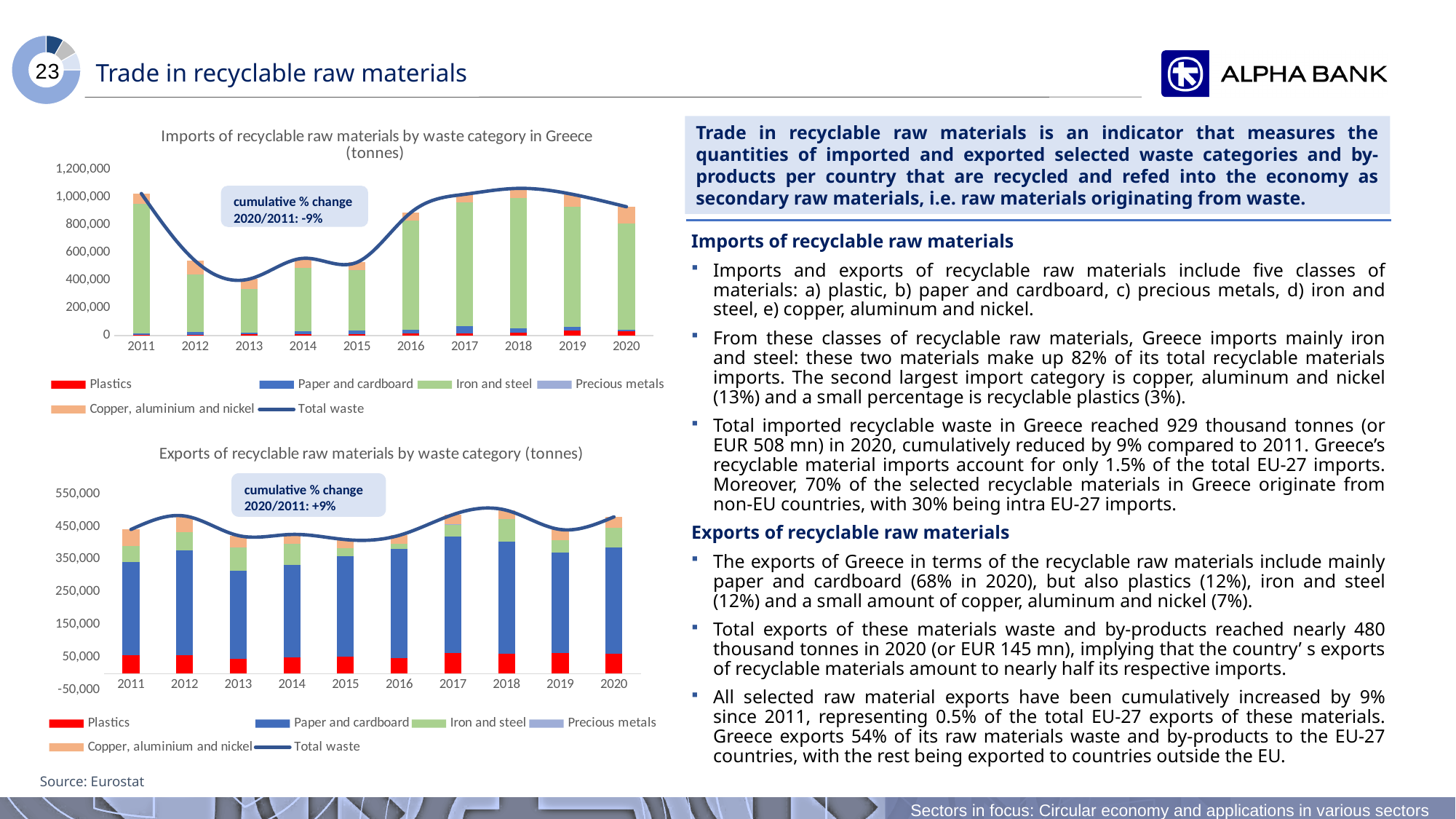
In the 'Imports of recyclable raw materials by waste category in Greece (tonnes)' chart, is the total waste for 2011 greater or less than 800,000? greater In the 'Exports of recyclable raw materials by waste category (tonnes)' chart, is the total waste for 2018 greater or less than 450,000? greater In the 'Imports of recyclable raw materials by waste category in Greece (tonnes)' chart, which is larger, the total waste in 2011 or in 2013? 2011 What cumulative % change 2020/2011 is annotated on the 'Exports of recyclable raw materials by waste category (tonnes)' chart? +9% In the 'Exports of recyclable raw materials by waste category (tonnes)' chart, which is larger, the total waste in 2018 or in 2015? 2018 In the 'Exports of recyclable raw materials by waste category (tonnes)' chart, is the total waste for 2013 greater or less than 450,000? less How many series does the legend of the 'Imports of recyclable raw materials by waste category in Greece (tonnes)' chart list? 6 What kind of chart is the 'Imports of recyclable raw materials by waste category in Greece (tonnes)' chart? Stacked bar chart with a line In the 'Imports of recyclable raw materials by waste category in Greece (tonnes)' chart, which year has the lowest total waste? 2013 What cumulative % change 2020/2011 is annotated on the 'Imports of recyclable raw materials by waste category in Greece (tonnes)' chart? -9% How many years are shown on the x axis of the 'Exports of recyclable raw materials by waste category (tonnes)' chart? 10